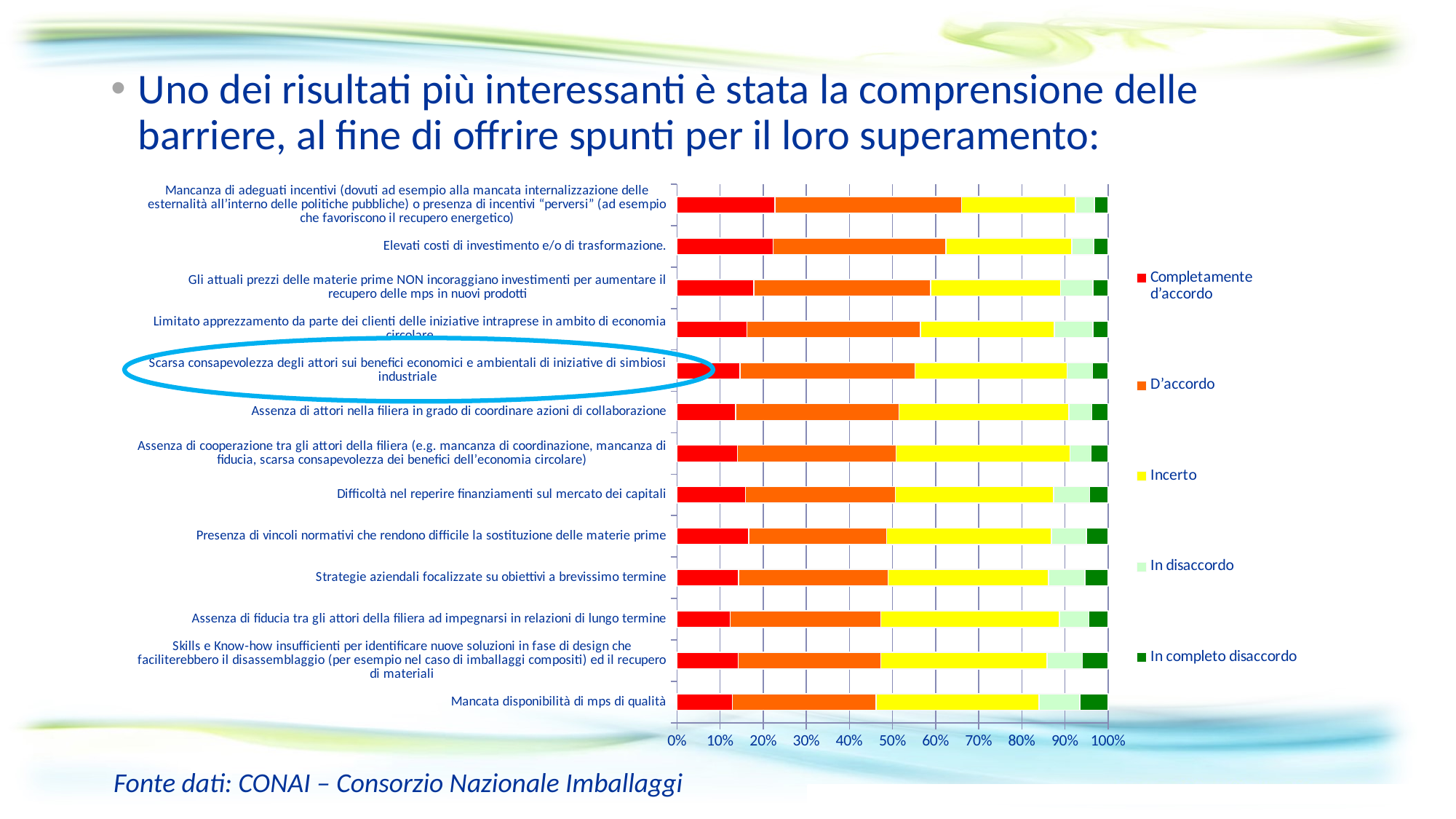
Is the 'Completamente d'accordo' value for 'Mancata disponibilità di mps di qualità' greater or less than 20%? less Is the 'Completamente d'accordo' value for 'Elevati costi di investimento e/o di trasformazione' greater or less than 20%? greater What value does each stacked bar total on the x axis? 100% Which legend entry is shown in red? Completamente d'accordo What kind of chart is shown on the slide? Stacked bar chart Is the 'Completamente d'accordo' value for 'Assenza di fiducia tra gli attori della filiera ad impegnarsi in relazioni di lungo termine' greater or less than 20%? less How many series does the chart legend list? 5 Which has the larger 'Completamente d'accordo' segment: 'Mancanza di adeguati incentivi' or 'Mancata disponibilità di mps di qualità'? Mancanza di adeguati incentivi What is the highest value shown on the x axis? 100% How many barrier categories are plotted in the chart? 13 Which legend entry is shown in yellow? Incerto